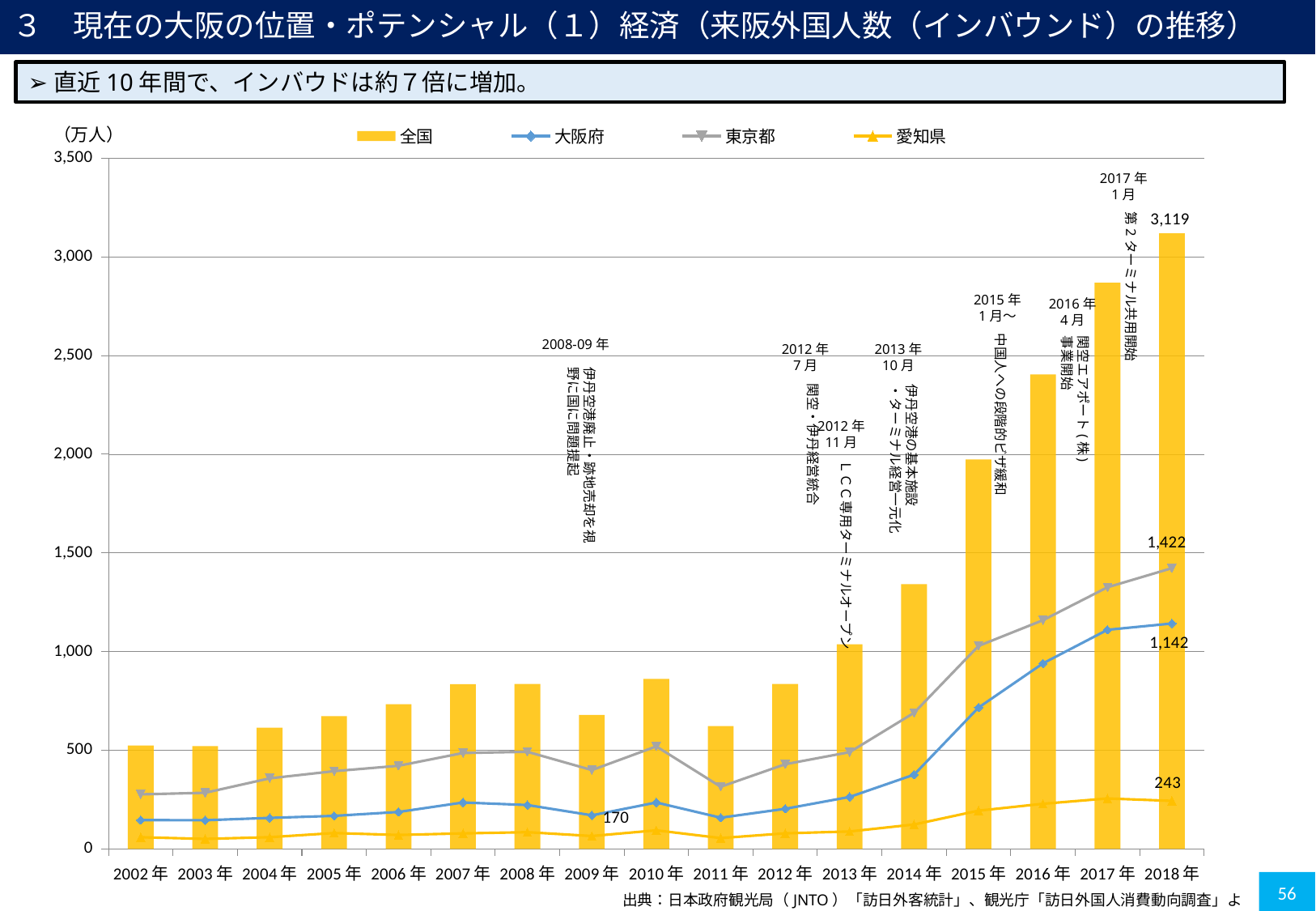
What is the value for 大阪府 in 2018年? 1,142 What is the value for 大阪府 in 2009年? 170 Is the value for 全国 in 2015年 greater or less than 1,500? greater What is the value for 愛知県 in 2018年? 243 By how much did the 大阪府 value increase from 2009年 to 2018年? 972 What is the value for 全国 in 2018年? 3,119 In 2018年, which is larger, the value for 東京都 or for 大阪府? 東京都 What is the difference between the 東京都 and 大阪府 values in 2018年? 280 How many series does the legend list? 4 In which year is the 全国 value highest? 2018年 What is the value for 東京都 in 2018年? 1,422 How many years are shown on the x axis? 17